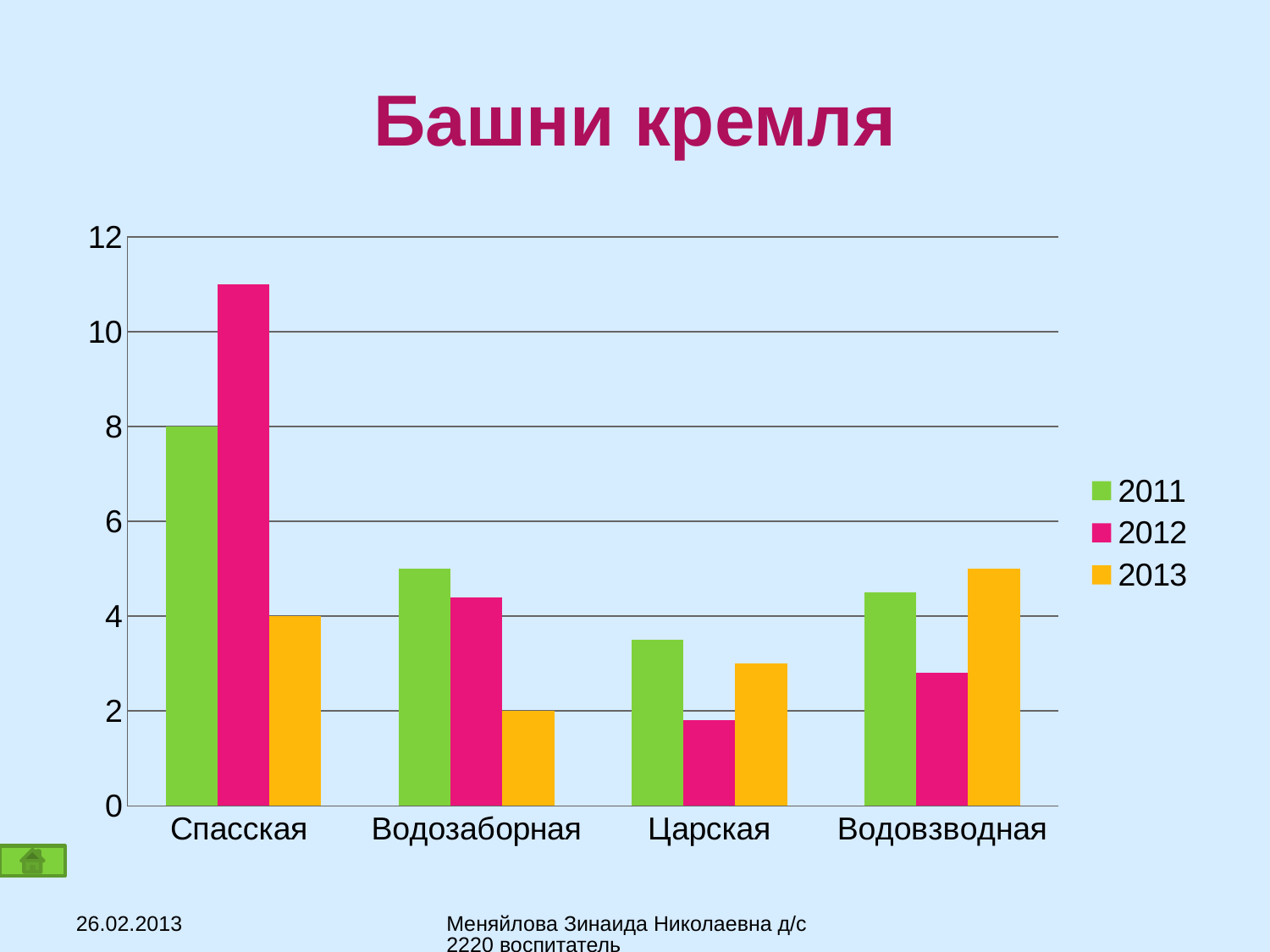
Which category has the tallest bar in the chart? Спасская Which category has the lowest 2012 value? Царская Is the value for Спасская in 2012 greater or less than 10? greater What is the difference between the 2011 and 2013 values for Спасская? 4 How many series does the legend list? 3 Is the value for Царская in 2012 greater or less than 2? less What is the value for Водозаборная in 2013? 2 How many categories are shown on the x axis? 4 What type of chart is shown on the slide? bar chart What is the title of the chart? Башни кремля What is the value for Спасская in 2013? 4 What is the value for Спасская in 2011? 8